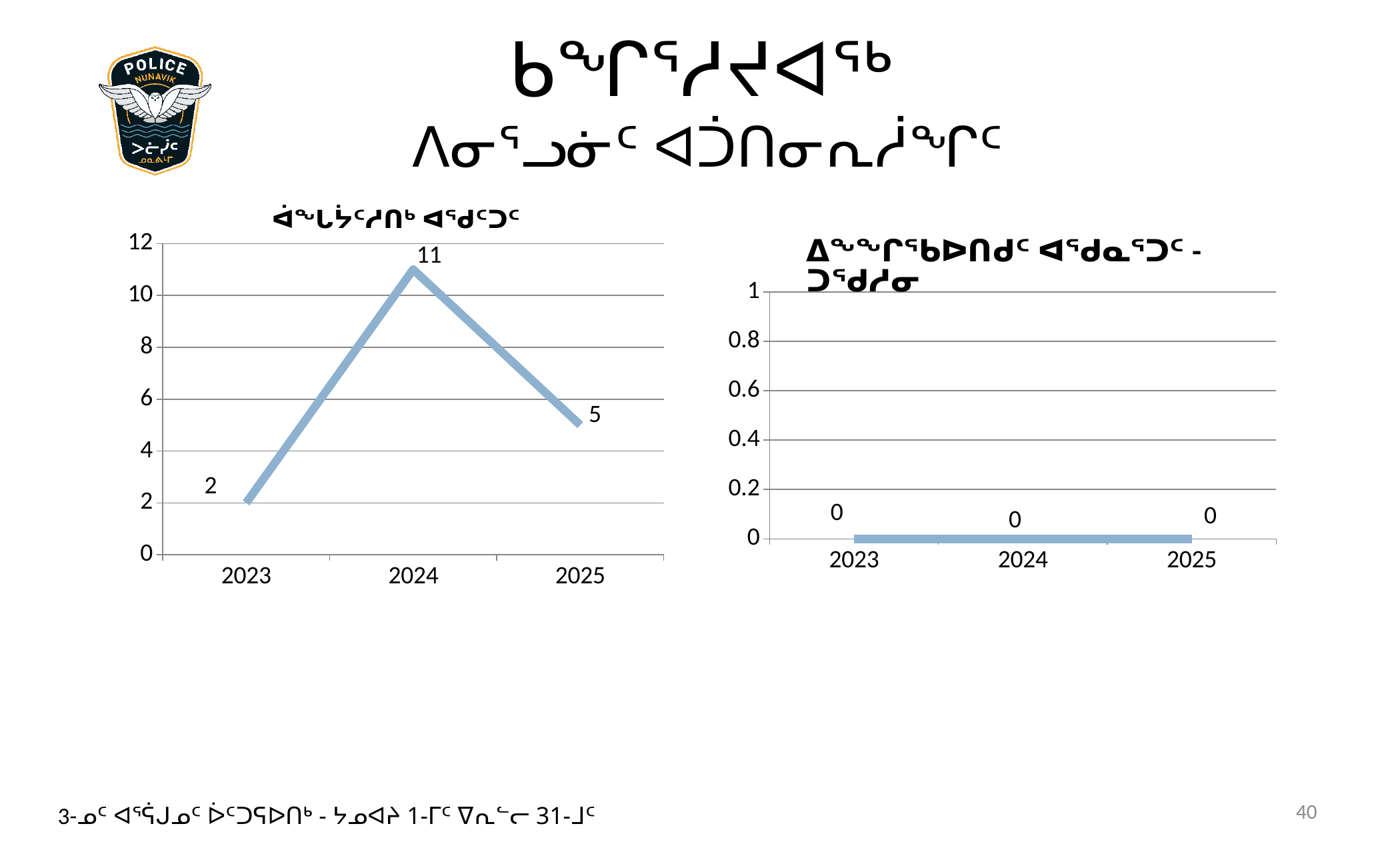
In the left chart, what is the difference between the values for 2024 and 2025? 6 How many years are plotted on the x axis of the left chart? 3 In the left chart, what is the value for 2024? 11 In the left chart, which year has the highest value? 2024 In the left chart, is the value for 2024 greater or less than 10? greater In the left chart, which year has the lowest value? 2023 In the right chart, what is the value for 2024? 0 In the left chart, does the value rise or fall from 2024 to 2025? fall What kind of chart is the left chart? line chart In the left chart, what is the value for 2023? 2 In the left chart, which is larger, the value for 2025 or the value for 2023? 2025 In the left chart, what is the value for 2025? 5